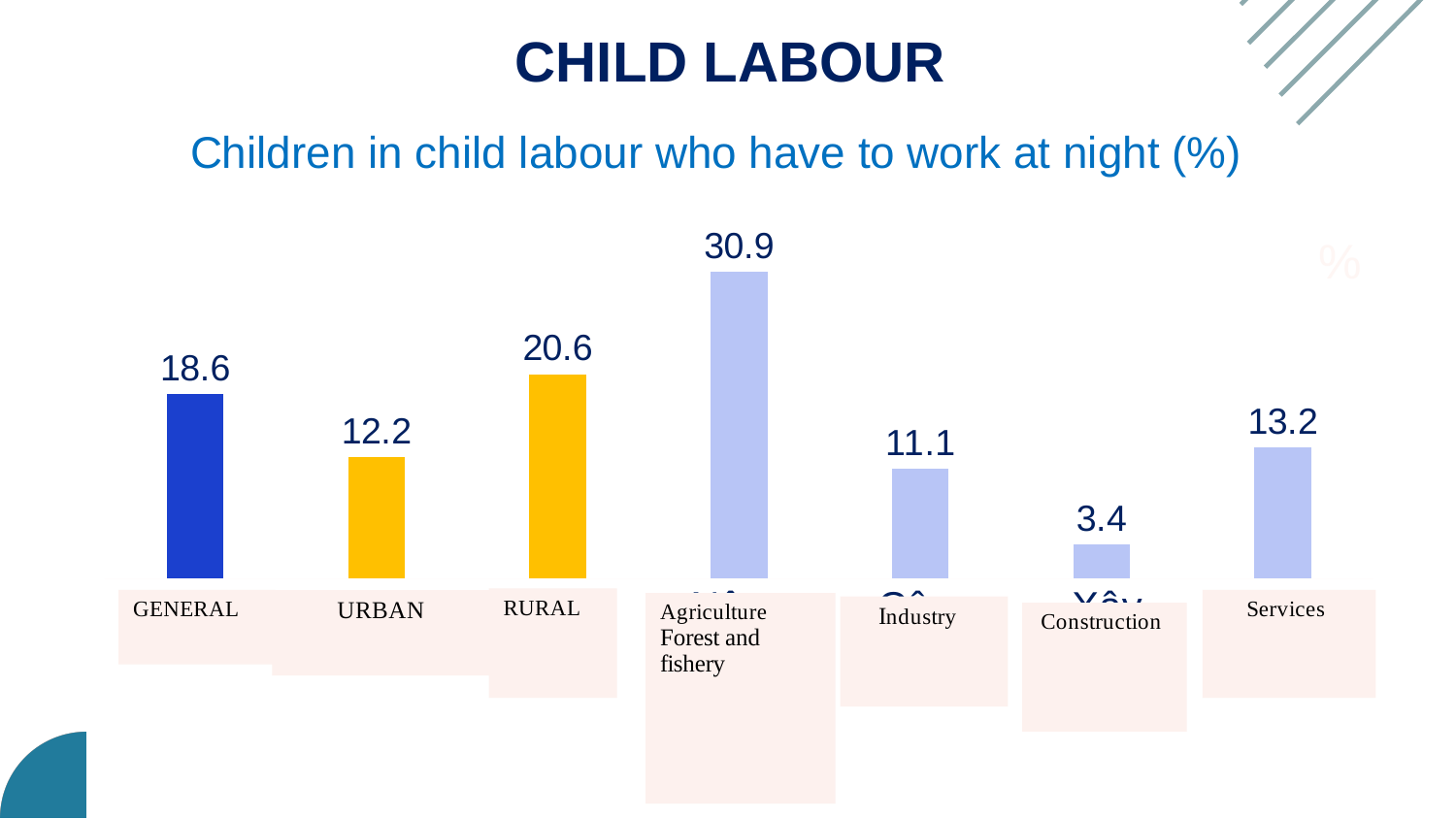
What is the difference between the Agriculture, Forest and fishery value and the Industry value? 19.8 Which is larger, the value for Services or the value for Industry? Services What is the title of the chart? Children in child labour who have to work at night (%) How many categories are shown in the chart? 7 What is the value for GENERAL? 18.6 What is the difference between the RURAL and URBAN values? 8.4 What is the value for Services? 13.2 What kind of chart is shown on the slide? Bar chart Which category has the lowest value? Construction What is the value for Construction? 3.4 What is the value for Agriculture, Forest and fishery? 30.9 Which category has the highest value? Agriculture, Forest and fishery